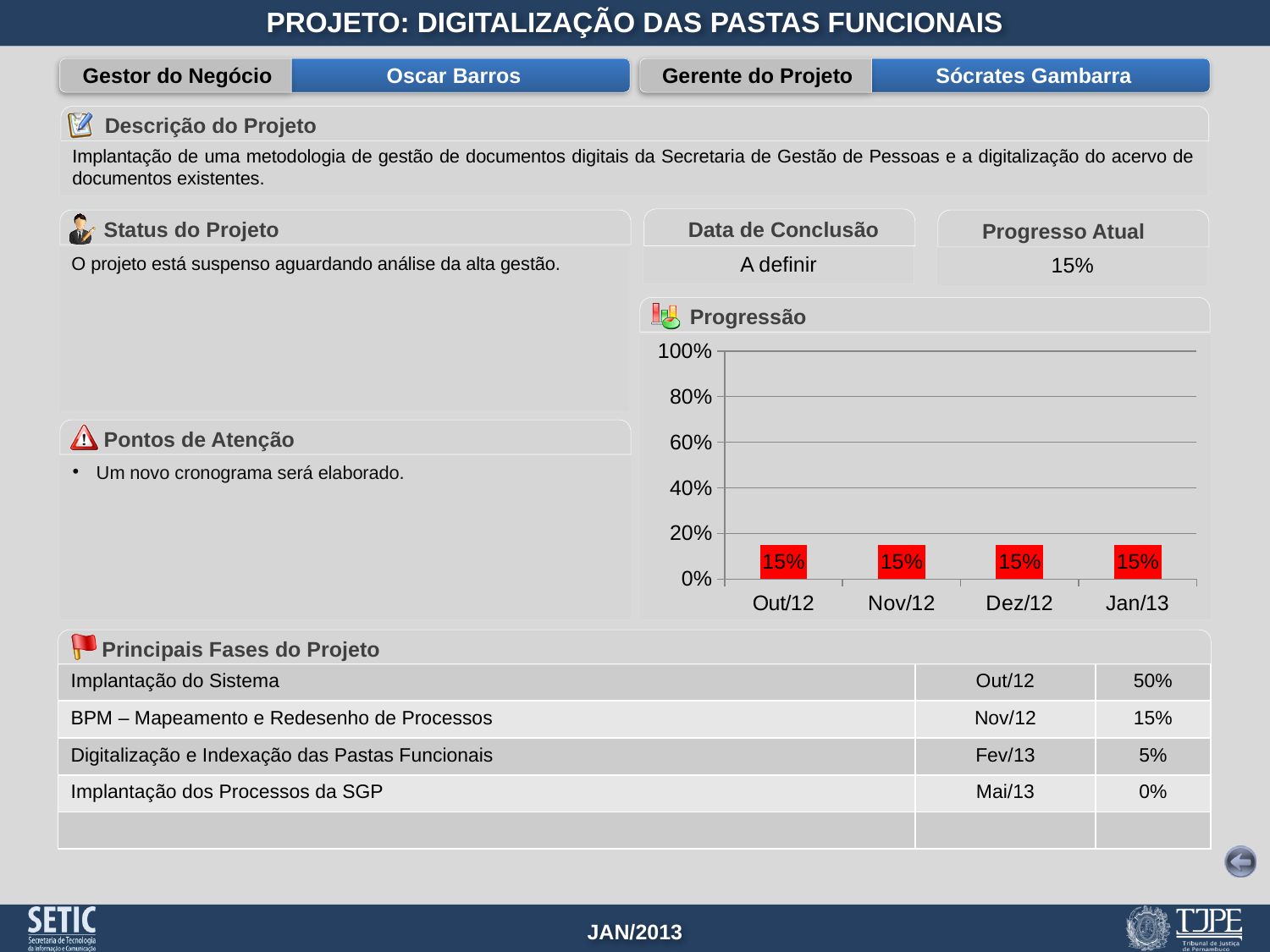
What colour are the bars in the Progressão chart? red What is the value for Out/12 in the Progressão chart? 15% Do the values in the Progressão chart rise, fall or stay flat from Out/12 to Jan/13? stay flat What is the value for Nov/12 in the Progressão chart? 15% Is the value for Jan/13 in the Progressão chart greater or less than 20%? less What is the value for Dez/12 in the Progressão chart? 15% What is the difference between the values for Out/12 and Jan/13 in the Progressão chart? 0% What kind of chart is the Progressão chart? bar chart What is the value for Jan/13 in the Progressão chart? 15% How many months are plotted on the x axis of the Progressão chart? 4 What is the highest value shown on the y axis of the Progressão chart? 100%